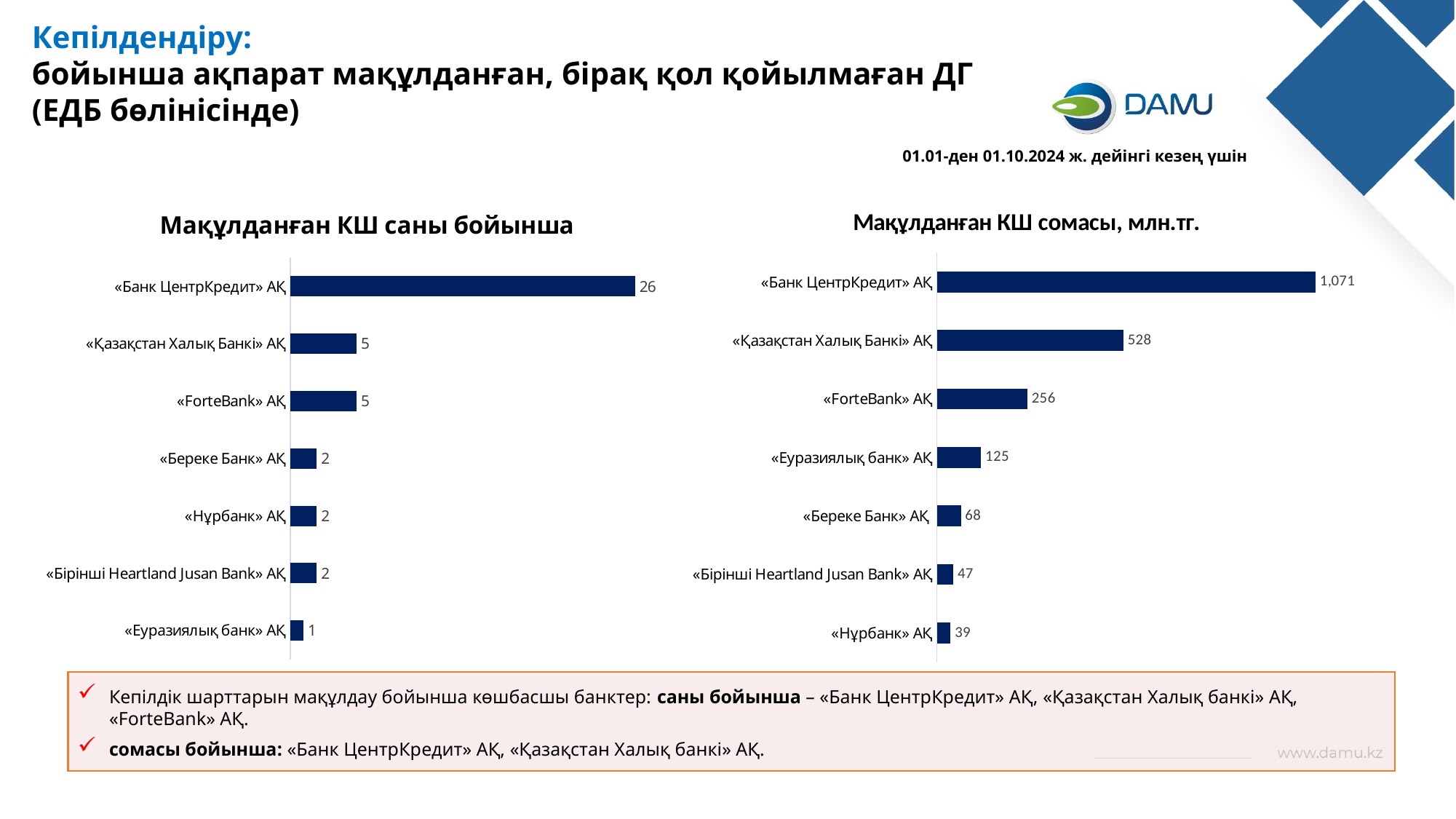
In the chart titled «Мақұлданған КШ сомасы, млн.тг.», which is larger: «Еуразиялық банк» АҚ or «Береке Банк» АҚ? «Еуразиялық банк» АҚ In the chart titled «Мақұлданған КШ саны бойынша», what is the value for «Бірінші Heartland Jusan Bank» АҚ? 2 In the chart titled «Мақұлданған КШ саны бойынша», what is the difference between «Банк ЦентрКредит» АҚ and «ForteBank» АҚ? 21 How many banks are shown in the chart titled «Мақұлданған КШ саны бойынша»? 7 In the chart titled «Мақұлданған КШ сомасы, млн.тг.», what is the value for «Нұрбанк» АҚ? 39 What kind of chart is the chart titled «Мақұлданған КШ сомасы, млн.тг.»? Bar chart In the chart titled «Мақұлданған КШ сомасы, млн.тг.», which bank has the highest value? «Банк ЦентрКредит» АҚ What is the title of the chart on the left side of the slide? Мақұлданған КШ саны бойынша In the chart titled «Мақұлданған КШ саны бойынша», which bank has the lowest value? «Еуразиялық банк» АҚ In the chart titled «Мақұлданған КШ сомасы, млн.тг.», what is the difference between «Банк ЦентрКредит» АҚ and «Қазақстан Халық Банкі» АҚ? 543 In the chart titled «Мақұлданған КШ саны бойынша», what is the value for «Банк ЦентрКредит» АҚ? 26 In the chart titled «Мақұлданған КШ сомасы, млн.тг.», what is the value for «ForteBank» АҚ? 256